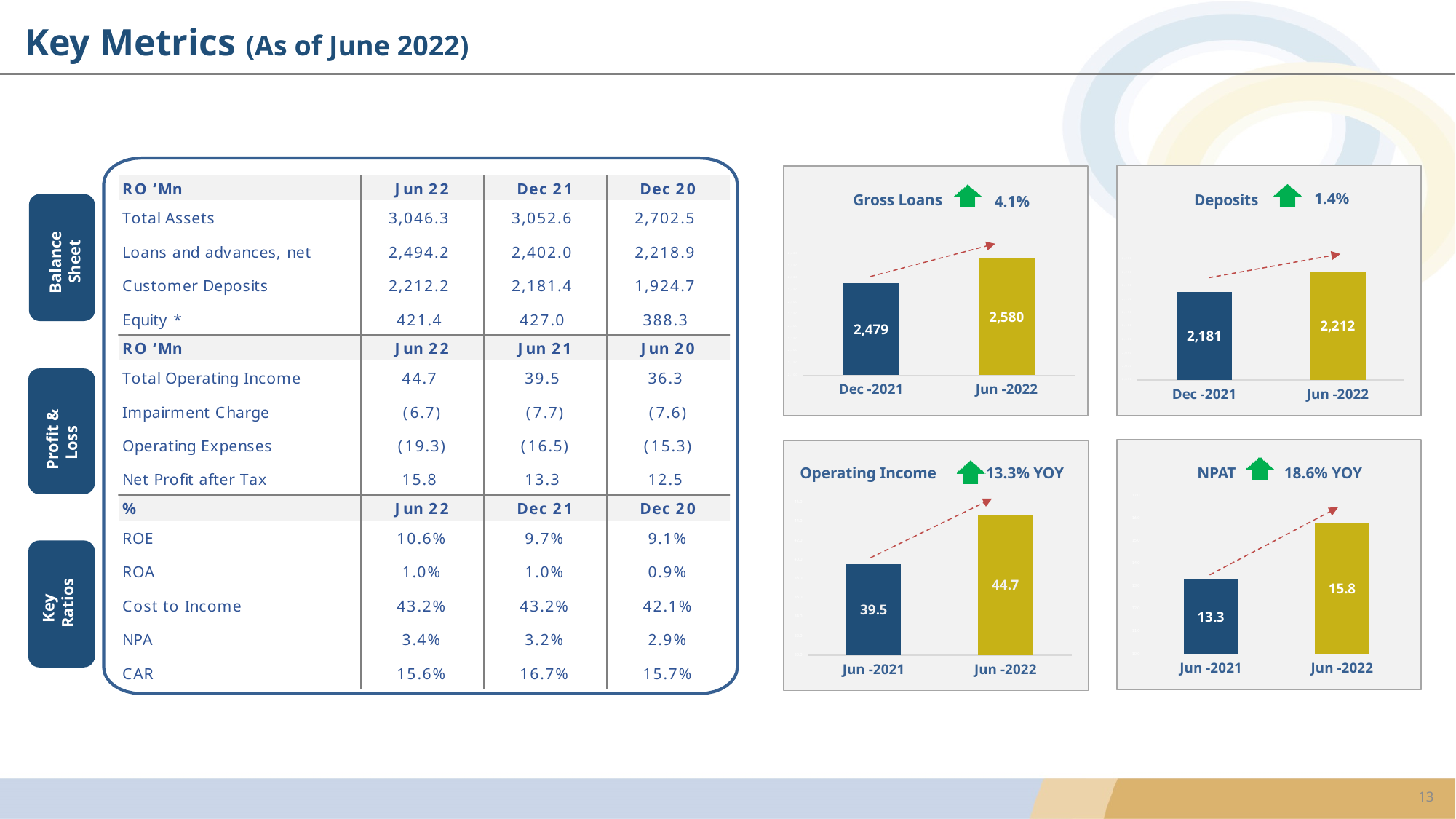
In the NPAT chart, what is the difference between the Jun -2022 and Jun -2021 values? 2.5 In the Operating Income chart, which period has the higher value, Jun -2021 or Jun -2022? Jun -2022 In the Deposits chart, what is the difference between the Jun -2022 and Dec -2021 values? 31 In the Deposits chart, what is the value for Jun -2022? 2,212 In the Operating Income chart, what is the value for Jun -2021? 39.5 In the Gross Loans chart, what is the value for Jun -2022? 2,580 How many bars are shown in the Operating Income chart? 2 In the Gross Loans chart, which period has the lowest value? Dec -2021 What type of chart is the NPAT chart? Bar chart In the NPAT chart, what is the value for Jun -2022? 15.8 In the Gross Loans chart, what is the value for Dec -2021? 2,479 What percentage change is shown next to the Deposits chart title? 1.4%